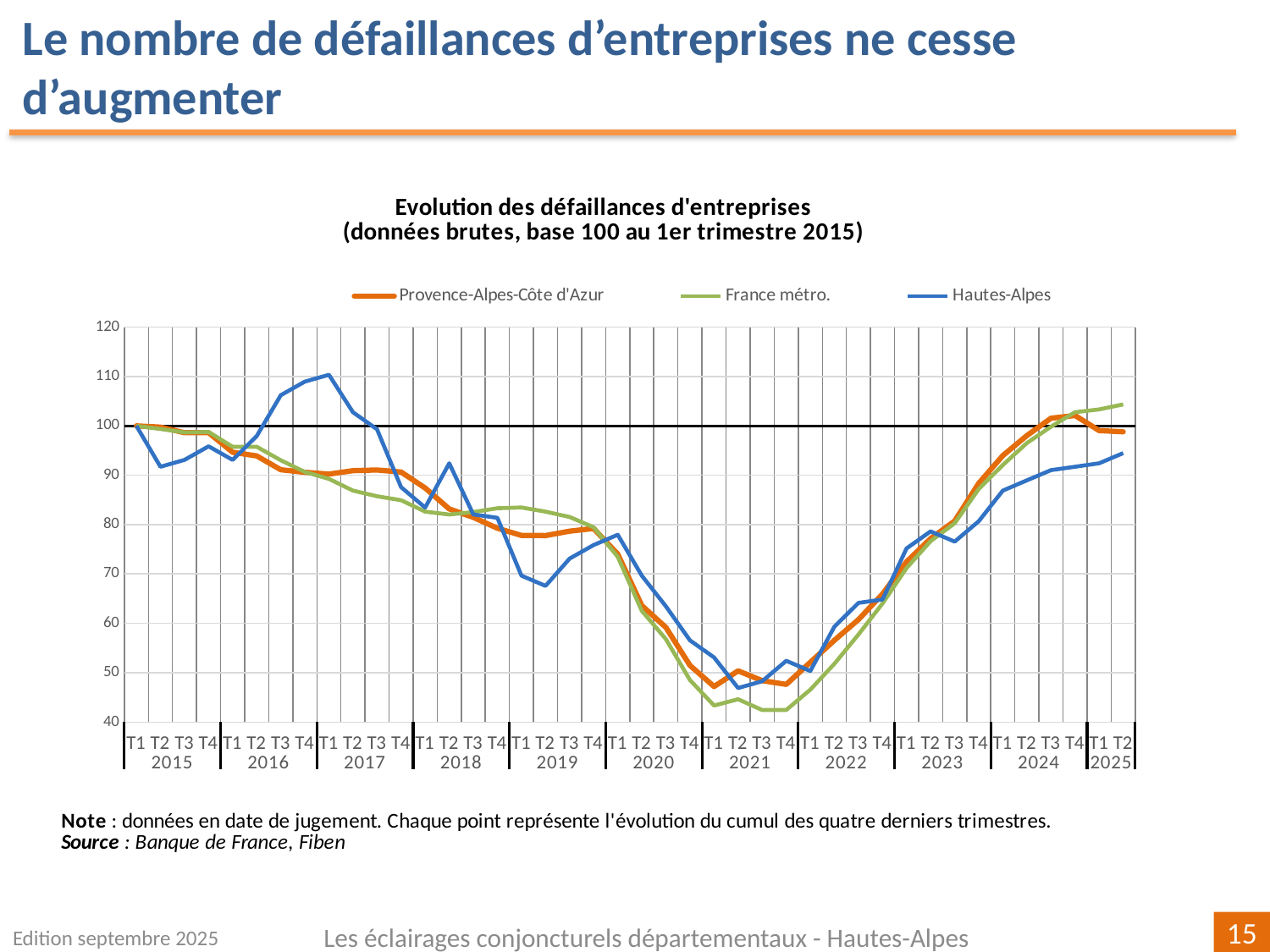
Is the value for France métro. at T3 2021 greater or less than 50? less How many series does the legend list? 3 Which series has the highest value at T1 2017? Hautes-Alpes What is the title of the chart? Evolution des défaillances d'entreprises (données brutes, base 100 au 1er trimestre 2015) What kind of chart is shown on the slide? line chart Does the Provence-Alpes-Côte d'Azur series rise or fall between T1 2021 and T4 2024? rise Which series is drawn in blue? Hautes-Alpes What is the value of the Hautes-Alpes series at T1 2015? 100 Which series has the lowest value at T3 2021? France métro. At T2 2025, which is higher: France métro. or Provence-Alpes-Côte d'Azur? France métro. Is the value for France métro. at T2 2025 greater or less than 100? greater Is the value for Hautes-Alpes at T1 2017 greater or less than 100? greater